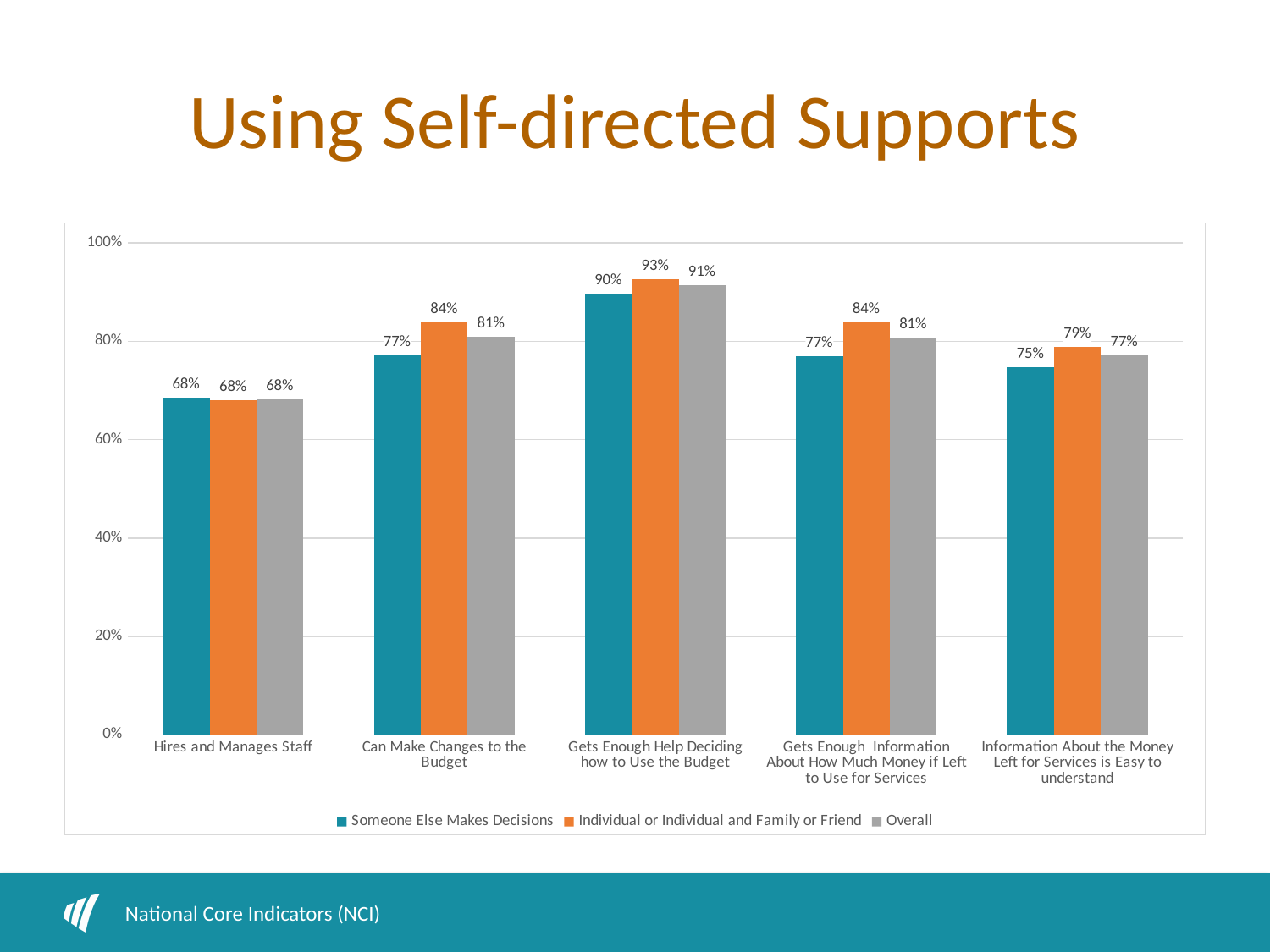
What kind of chart is shown on the slide? Bar chart What is the difference between the Individual or Individual and Family or Friend value and the Someone Else Makes Decisions value for Can Make Changes to the Budget? 7% Which category has the lowest value for Someone Else Makes Decisions? Hires and Manages Staff Is the Overall value for Hires and Manages Staff greater or less than 80%? less What is the title of the slide? Using Self-directed Supports What is the value for Individual or Individual and Family or Friend for Can Make Changes to the Budget? 84% How many categories are shown on the x axis? 5 Which category has the highest Overall value? Gets Enough Help Deciding how to Use the Budget For Gets Enough Information About How Much Money if Left to Use for Services, which is larger: Someone Else Makes Decisions or Overall? Overall How many series does the legend list? 3 What is the Overall value for Gets Enough Help Deciding how to Use the Budget? 91% What is the value for Someone Else Makes Decisions for Information About the Money Left for Services is Easy to understand? 75%